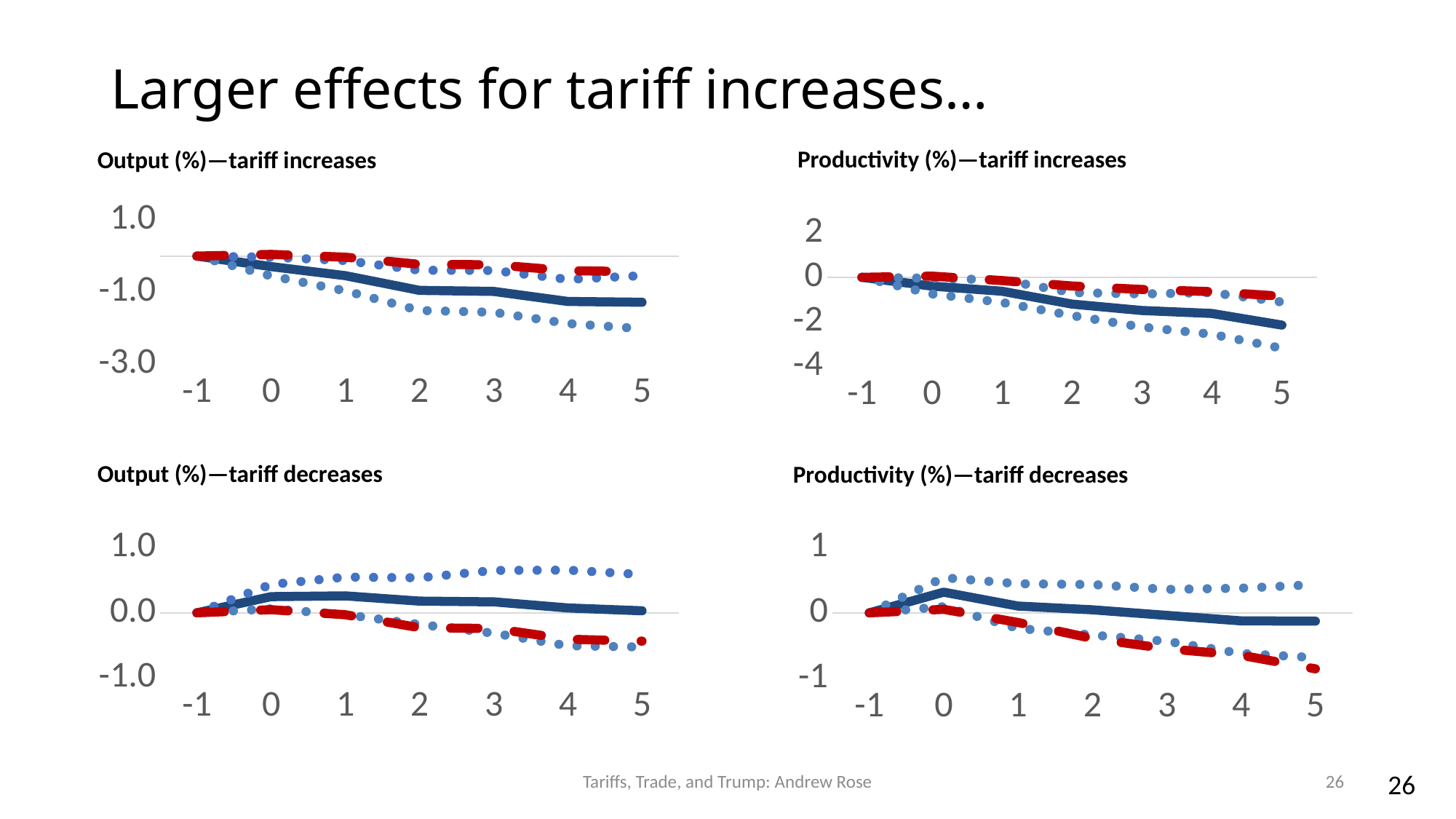
In the "Productivity (%)—tariff decreases" chart, does the solid blue line rise or fall from x = -1 to x = 0? rise How many x-axis tick values are shown on the "Productivity (%)—tariff decreases" chart? 7 In the "Output (%)—tariff decreases" chart, does the solid blue line rise or fall from x = 1 to x = 5? fall What is the title of the chart in the top-right position of the slide? Productivity (%)—tariff increases What kind of chart is the "Output (%)—tariff increases" chart? line chart In the "Productivity (%)—tariff decreases" chart, is the value of the red dashed line at x = 5 greater or less than 0? less In the "Output (%)—tariff decreases" chart, is the value of the upper dotted blue line at x = 5 greater or less than 0.0? greater How many charts are shown on the slide? 4 In the "Output (%)—tariff increases" chart, is the value of the red dashed line at x = 5 greater or less than -1.0? greater In the "Productivity (%)—tariff increases" chart, does the solid blue line rise or fall from x = 0 to x = 5? fall